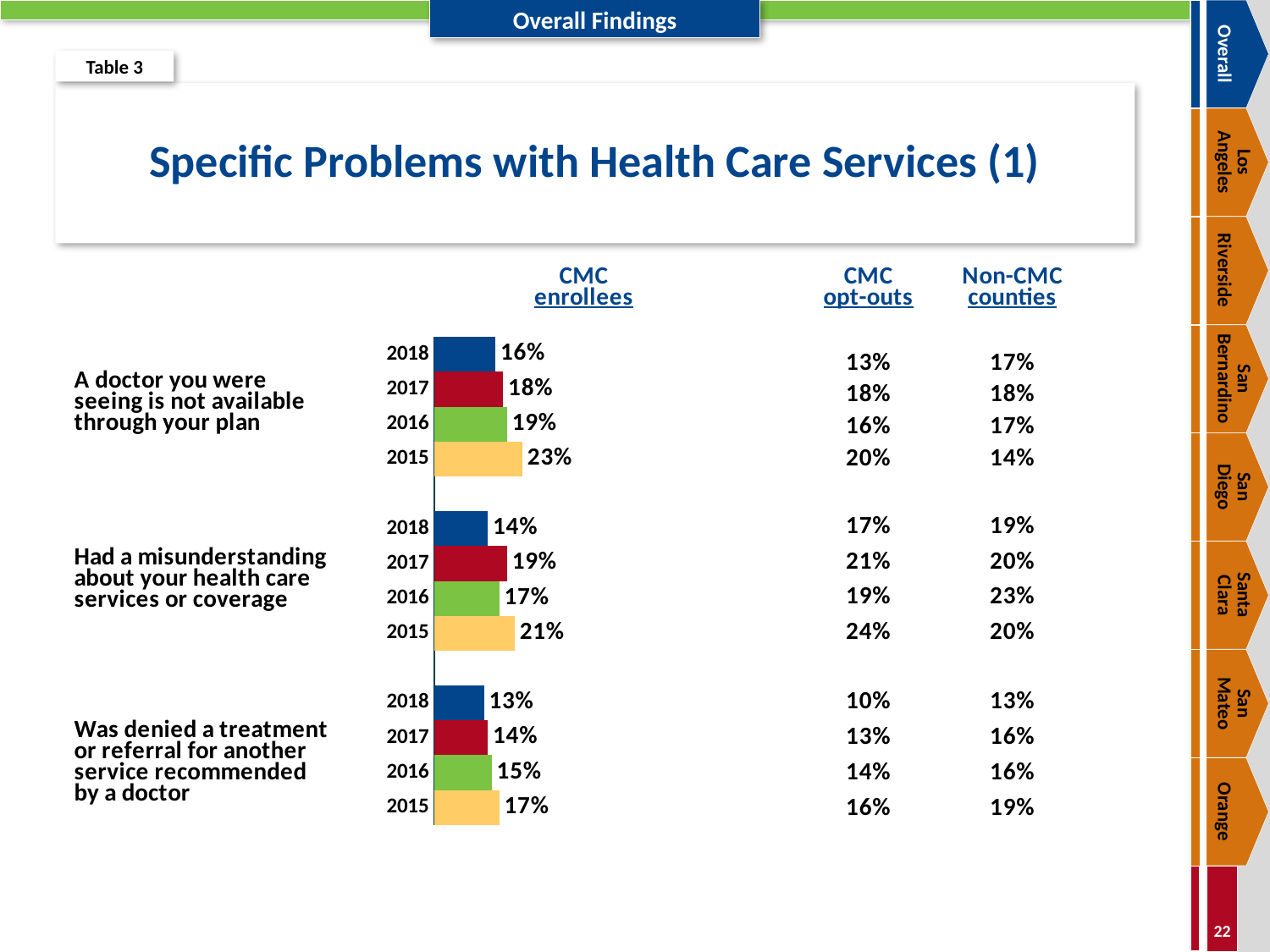
How many bars are in the 'A doctor you were seeing is not available through your plan' bar chart? 4 In the 'A doctor you were seeing is not available through your plan' bar chart, what is the CMC enrollees value for 2018? 16% In the 'Was denied a treatment or referral for another service recommended by a doctor' bar chart, what is the difference between the 2015 and 2018 CMC enrollees values? 4% In the 'Had a misunderstanding about your health care services or coverage' bar chart, which is larger, the 2016 or the 2015 CMC enrollees value? 2015 In the 'A doctor you were seeing is not available through your plan' bar chart, what is the difference between the 2015 and 2018 CMC enrollees values? 7% In the 'Had a misunderstanding about your health care services or coverage' bar chart, what is the CMC enrollees value for 2017? 19% In the 'A doctor you were seeing is not available through your plan' bar chart, which year has the highest CMC enrollees value? 2015 In the 'Was denied a treatment or referral for another service recommended by a doctor' bar chart, what is the CMC enrollees value for 2016? 15% In the 'Had a misunderstanding about your health care services or coverage' bar chart, which year has the lowest CMC enrollees value? 2018 In the 'Was denied a treatment or referral for another service recommended by a doctor' bar chart, do the CMC enrollees values rise or fall from 2015 to 2018? Fall What kind of chart is used to show the CMC enrollees values on this slide? Bar chart In the 'Was denied a treatment or referral for another service recommended by a doctor' bar chart, which year has the highest CMC enrollees value? 2015